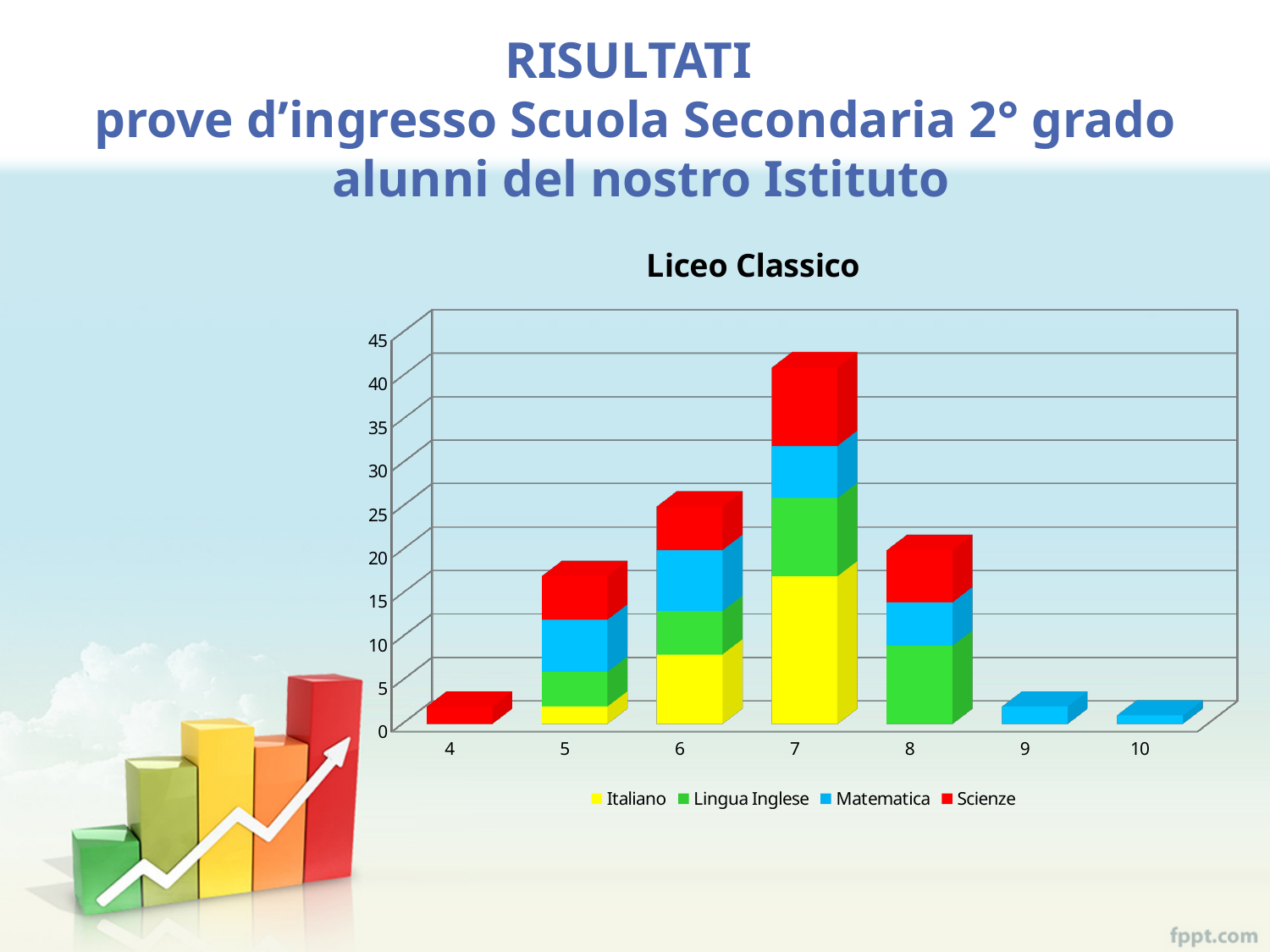
Which stacked bar is taller, category 7 or category 8? 7 Is the total value for category 7 greater or less than 35? greater Is the total value for category 9 greater or less than 5? less What type of chart is shown on the slide? stacked bar chart What is the title of the chart? Liceo Classico Which stacked bar is taller, category 5 or category 6? 6 Is the total value for category 4 greater or less than 5? less Which category has the tallest stacked bar? 7 Which series is shown in red in the legend? Scienze How many categories are shown on the x axis? 7 How many series does the legend list? 4